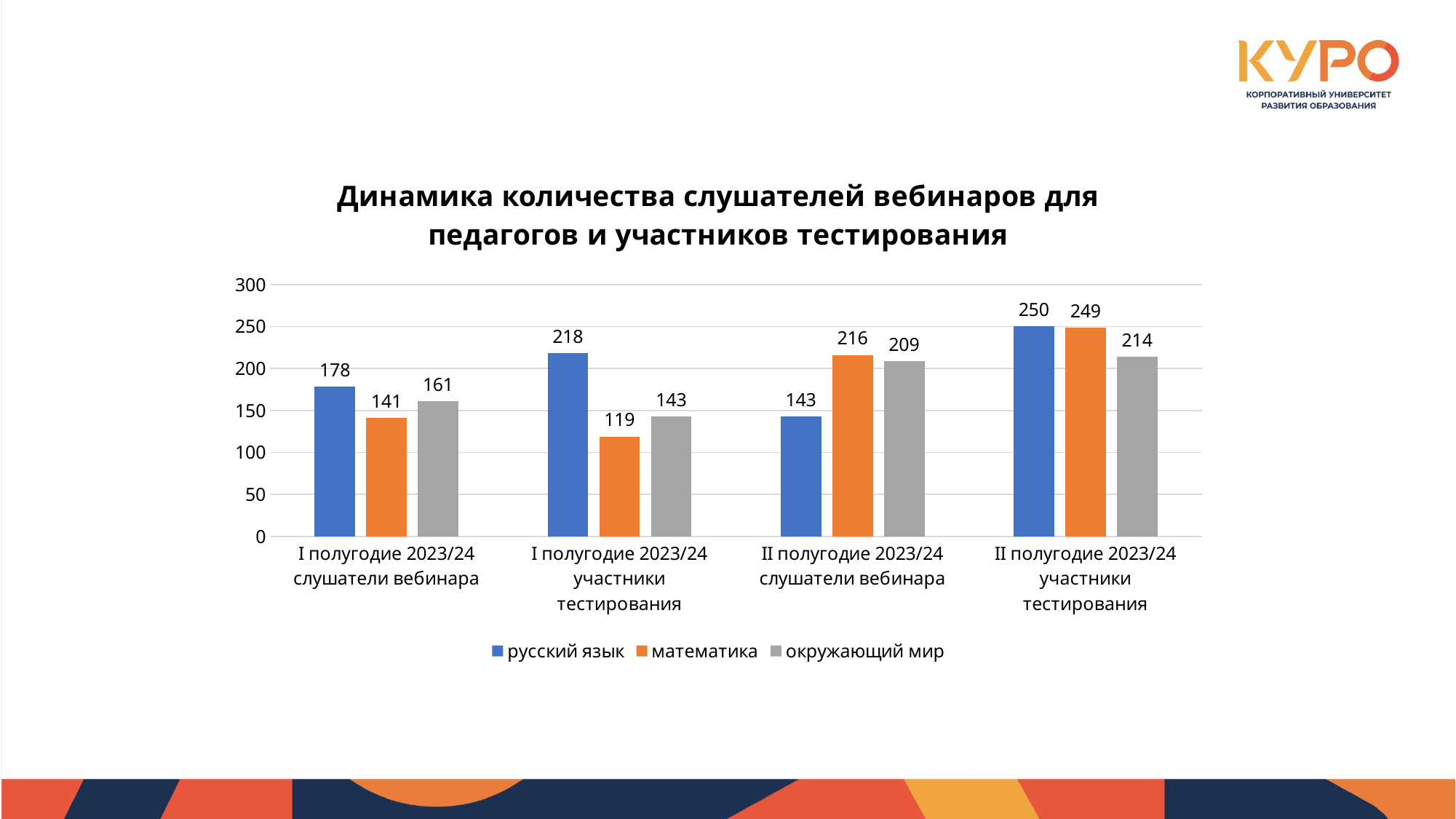
What is the difference between the русский язык values for 'I полугодие 2023/24 участники тестирования' and 'II полугодие 2023/24 участники тестирования'? 32 How many categories are shown on the x axis? 4 What is the value for окружающий мир in the category 'II полугодие 2023/24 слушатели вебинара'? 209 What is the value for математика in the category 'I полугодие 2023/24 участники тестирования'? 119 Is the value for окружающий мир in 'I полугодие 2023/24 слушатели вебинара' greater or less than 150? greater How many series does the legend list? 3 Which is larger: the математика value for 'II полугодие 2023/24 слушатели вебинара' or the окружающий мир value for the same category? математика What is the value for русский язык in the category 'I полугодие 2023/24 слушатели вебинара'? 178 Which series has the highest value in the category 'II полугодие 2023/24 участники тестирования'? русский язык Which series has the lowest value in the category 'I полугодие 2023/24 участники тестирования'? математика What is the title of the chart? Динамика количества слушателей вебинаров для педагогов и участников тестирования What kind of chart is shown on the slide? bar chart